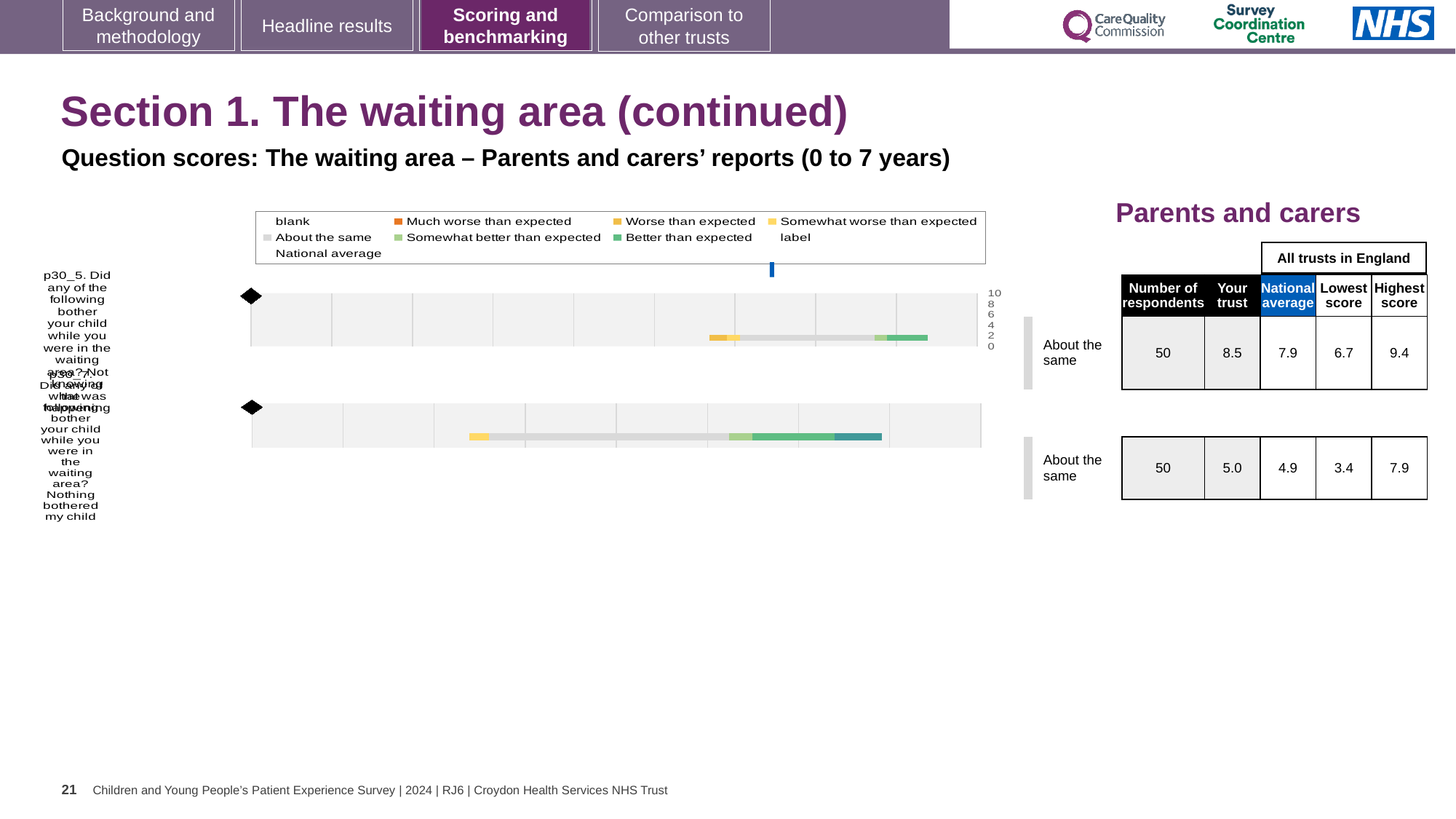
What kind of chart is used to show the question scores on this slide? bar chart What is the maximum value shown on the chart's score axis? 10 In the table beside the chart, what is the national average score for question p30_7? 4.9 How many respondents answered question p30_5 according to the table beside the chart? 50 How many survey questions (rows) are plotted in the chart? 2 For question p30_5, which is larger: the 'Your trust' score or the national average? Your trust What benchmark category is given for both questions next to the chart? About the same For question p30_5, what is the difference between the 'Your trust' score and the national average in the table beside the chart? 0.6 In the table beside the chart, what is the highest score among all trusts in England for question p30_5? 9.4 In the table beside the chart, what is the lowest score among all trusts in England for question p30_7? 3.4 In the table beside the chart, what is the 'Your trust' score for question p30_5? 8.5